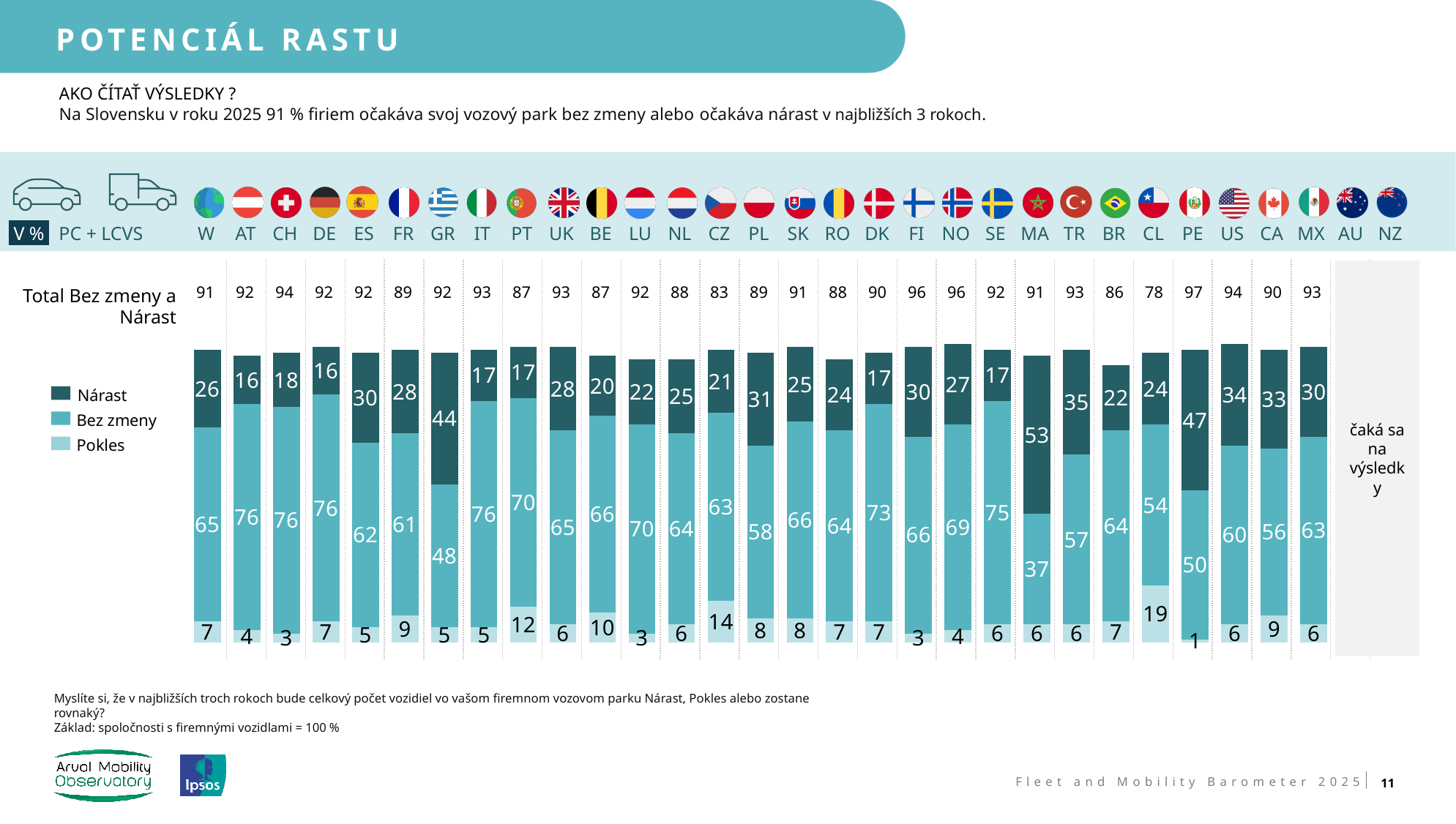
What is the 'Total Bez zmeny a Nárast' value for FI? 96 Which country has the lowest 'Total Bez zmeny a Nárast' value? CL How many series does the legend list? 3 What is the Bez zmeny value for GR? 48 What is the difference between the Nárast values for PE and W? 21 Which country has the highest Nárast value? MA What is the Pokles value for PT? 12 What is the Nárast value for SK? 25 Which has a larger Bez zmeny value, TR or DK? DK What is the total of the Nárast, Bez zmeny and Pokles segments for CZ? 98 What kind of chart is shown on the slide? Stacked bar chart Which country has the lowest Pokles value? PE